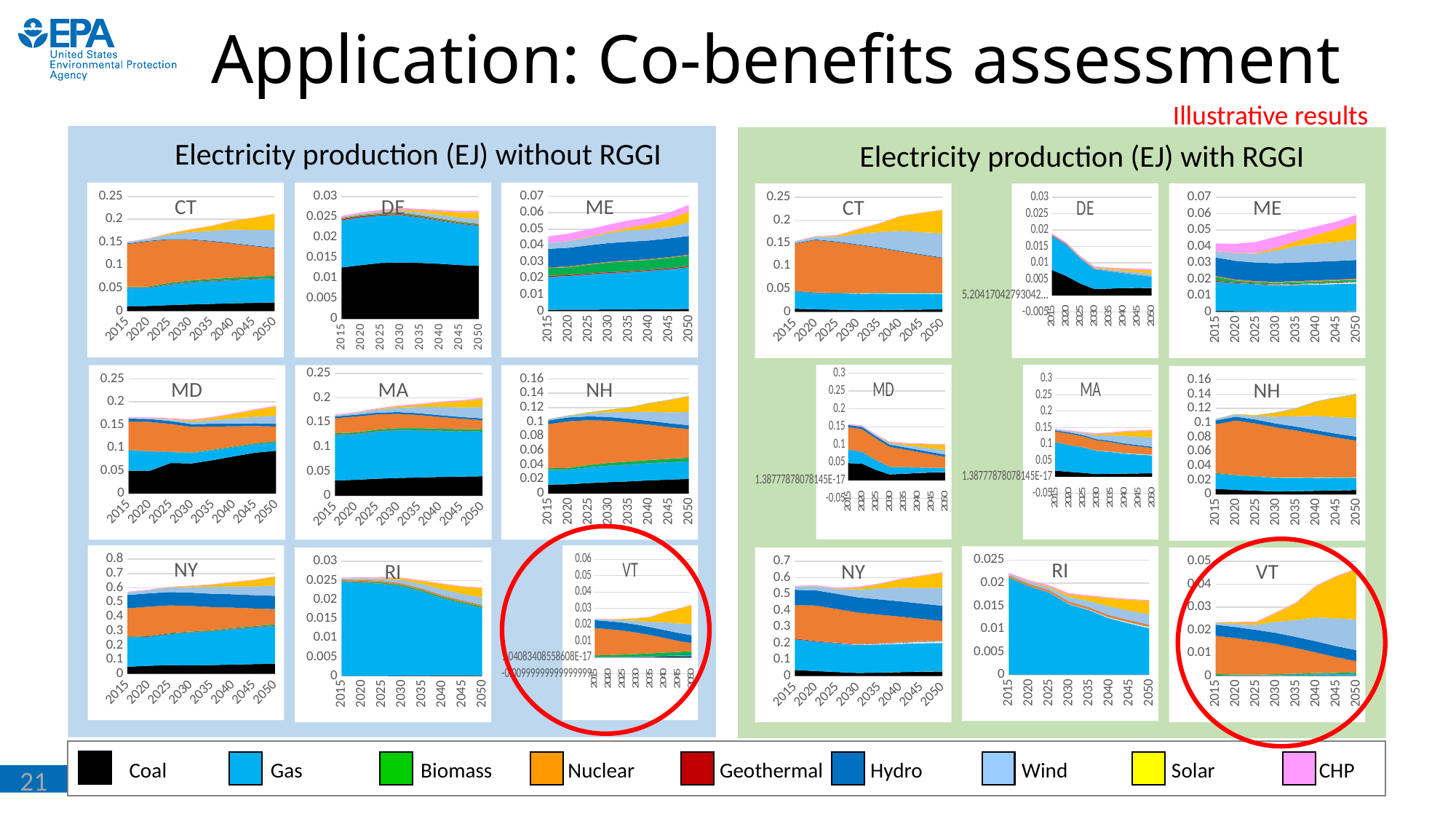
How many energy sources does the legend at the bottom of the slide list? 9 In the 'with RGGI' panel, is the total electricity production for VT in 2050 greater or less than 0.03? greater How many state charts are shown in the 'Electricity production (EJ) with RGGI' panel? 9 What kind of chart is used for each state in the 'Electricity production (EJ) without RGGI' panel? Stacked area chart In the 'with RGGI' panel, is the total electricity production for RI in 2050 greater or less than 0.02? less In the 'without RGGI' panel, is the total electricity production for CT in 2050 greater or less than 0.15? greater In the 'with RGGI' panel, does total electricity production for VT rise or fall from 2015 to 2050? rise How many years are marked on the x axis of the NY chart in the 'without RGGI' panel? 8 In the 'with RGGI' panel, does total electricity production for RI rise or fall from 2015 to 2050? fall In the 'without RGGI' panel, which has the larger total electricity production in 2050, NY or CT? NY Which state's chart is circled in red in both panels? VT